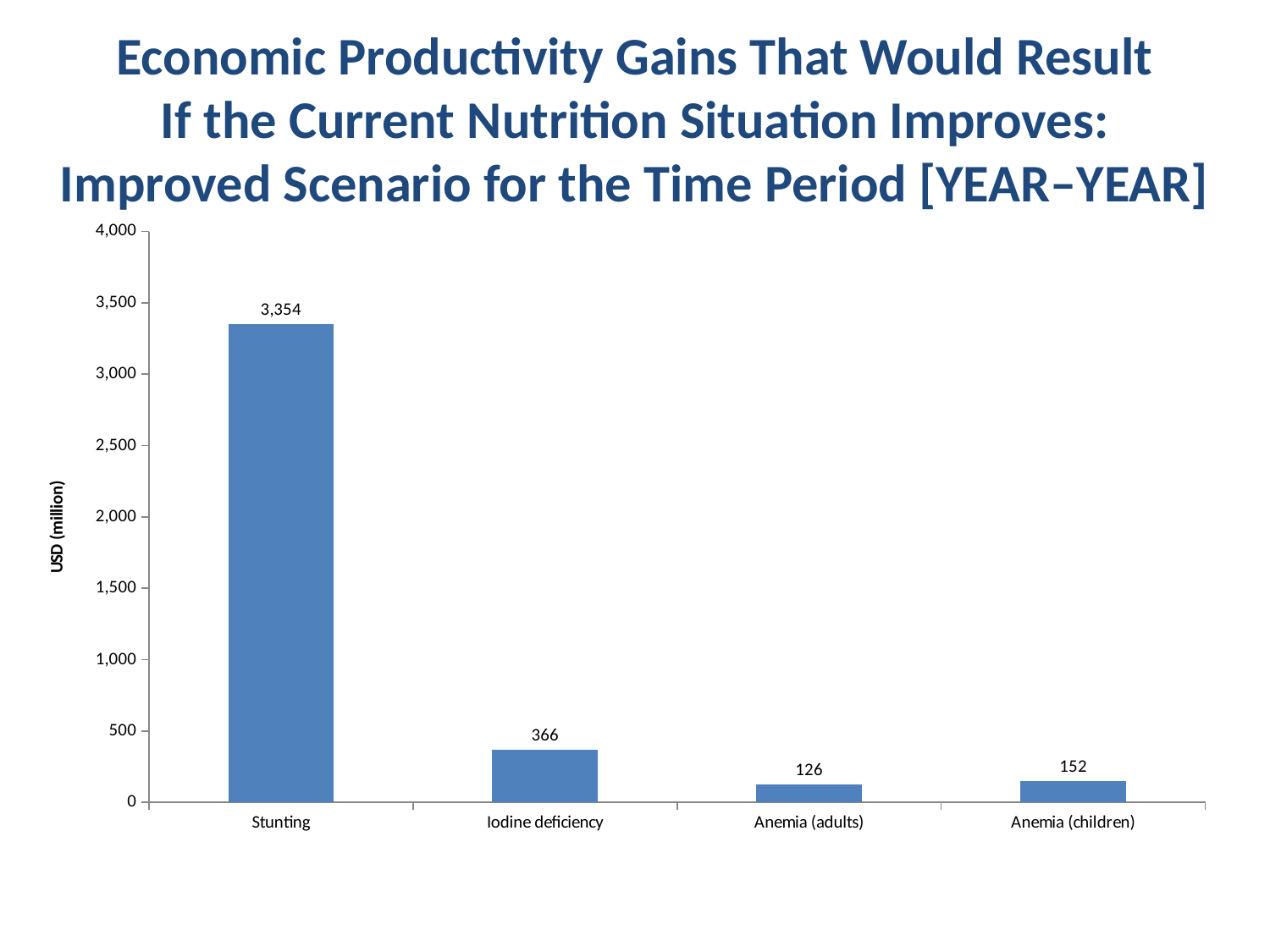
What is the value for Anemia (adults)? 126 Which is larger, the value for Iodine deficiency or the value for Anemia (children)? Iodine deficiency What is the label of the vertical axis? USD (million) What is the difference between the values for Anemia (children) and Anemia (adults)? 26 How many categories are shown on the x axis? 4 What is the value for Stunting? 3,354 Which category has the highest value? Stunting What is the difference between the values for Stunting and Iodine deficiency? 2,988 Which category has the lowest value? Anemia (adults) What is the value for Iodine deficiency? 366 What is the value for Anemia (children)? 152 What kind of chart is shown on the slide? Bar chart